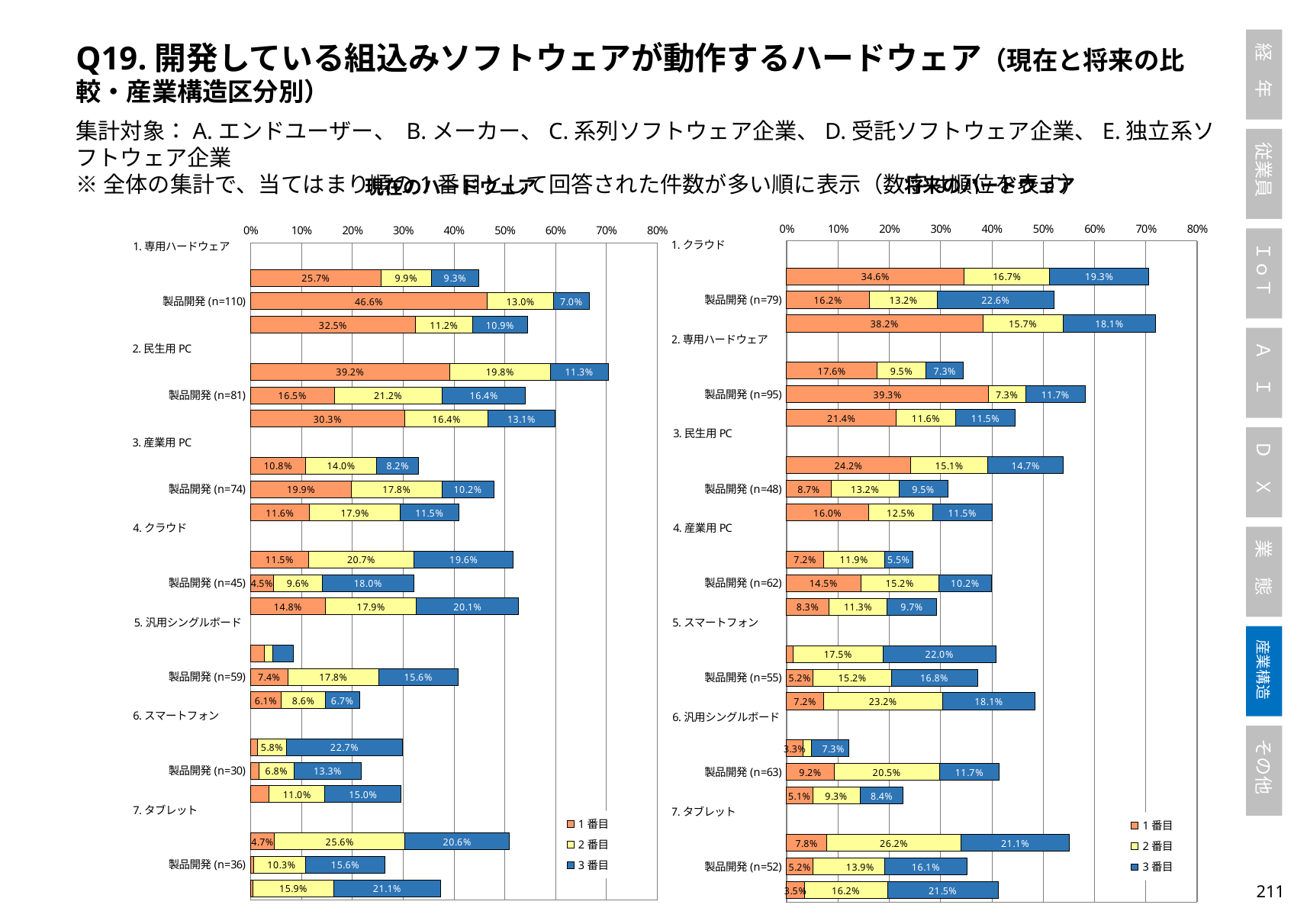
What are the legend entries of the right chart? 1番目, 2番目, 3番目 In the left chart, what is the 1番目 value for 製品開発 (n=110) under 1. 専用ハードウェア? 46.6% In the right chart, which is larger for 製品開発 (n=55) under 5. スマートフォン: the 2番目 value or the 3番目 value? 3番目 How many numbered hardware categories are shown in the left chart? 7 In the right chart, what is the 3番目 value for 製品開発 (n=79) under 1. クラウド? 22.6% What type of chart is the right chart? Stacked bar chart In the right chart, what is the total of the stacked bar for 製品開発 (n=95) under 2. 専用ハードウェア? 58.3% How many series does the legend of the left chart list? 3 In the left chart, what is the difference between the 1番目 values for 製品開発 (n=110) under 1. 専用ハードウェア and 製品開発 (n=74) under 3. 産業用PC? 26.7% In the right chart, what is the 2番目 value for 製品開発 (n=63) under 6. 汎用シングルボード? 20.5% In the left chart, what is the total of the stacked bar for 製品開発 (n=110) under 1. 専用ハードウェア? 66.6% In the left chart, what is the 2番目 value for 製品開発 (n=81) under 2. 民生用PC? 21.2%